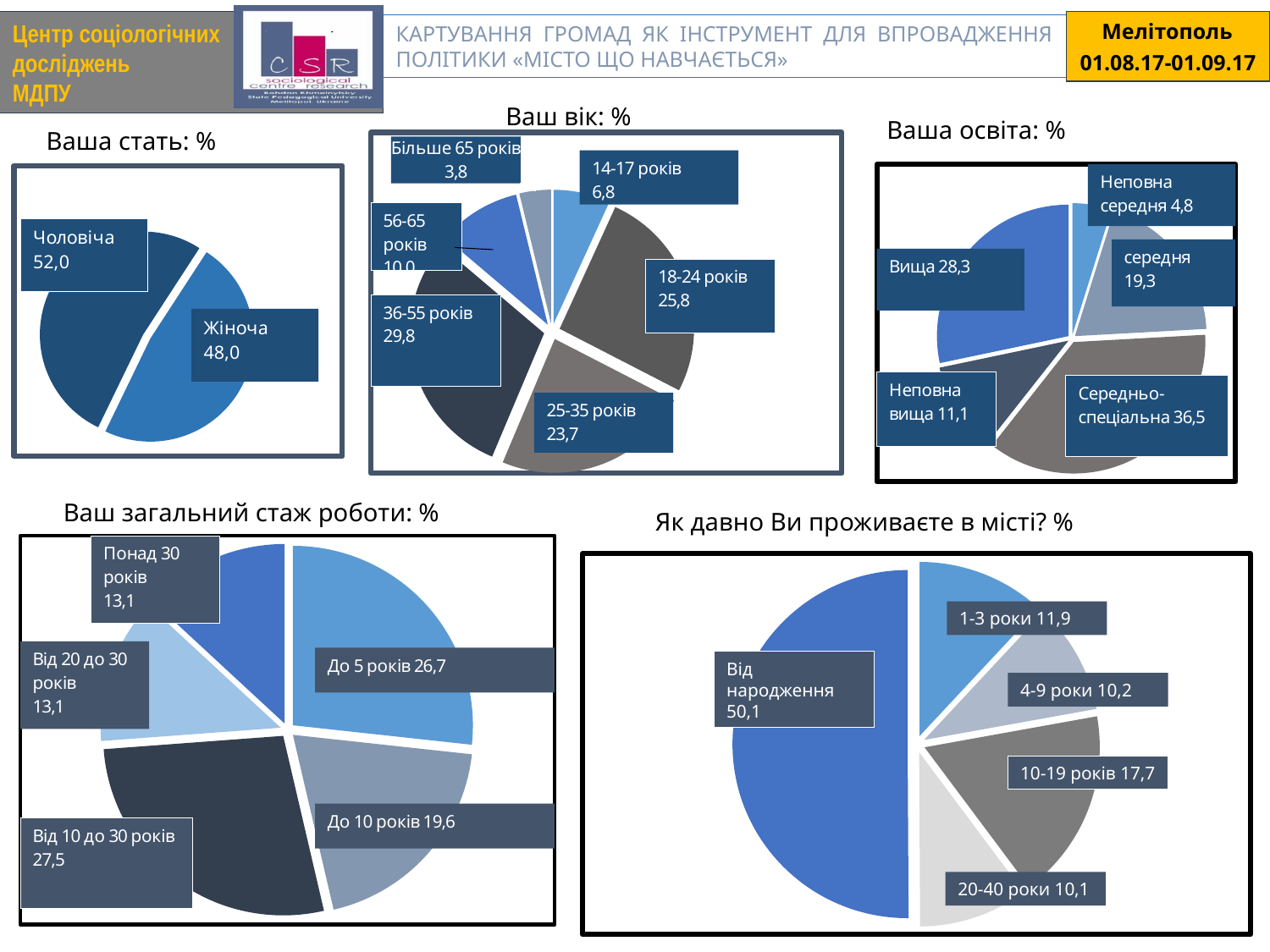
In the chart 'Ваша стать: %', what is the value for Чоловіча? 52,0 In the chart 'Ваша освіта: %', how many categories are shown? 5 In the chart 'Ваша стать: %', what is the difference between Чоловіча and Жіноча? 4,0 In the chart 'Ваш вік: %', what is the value for 18-24 років? 25,8 In the chart 'Ваш загальний стаж роботи: %', what is the difference between До 5 років and До 10 років? 7,1 In the chart 'Ваша освіта: %', what is the value for Середньо-спеціальна? 36,5 In the chart 'Ваша освіта: %', which is larger: Вища or середня? Вища In the chart 'Ваш загальний стаж роботи: %', what is the value for Від 10 до 30 років? 27,5 In the chart 'Ваш вік: %', which age group has the lowest value? Більше 65 років In the chart 'Ваш вік: %', which age group has the highest value? 36-55 років What type of chart is used for 'Як давно Ви проживаєте в місті? %'? Pie chart In the chart 'Як давно Ви проживаєте в місті? %', what is the value for Від народження? 50,1